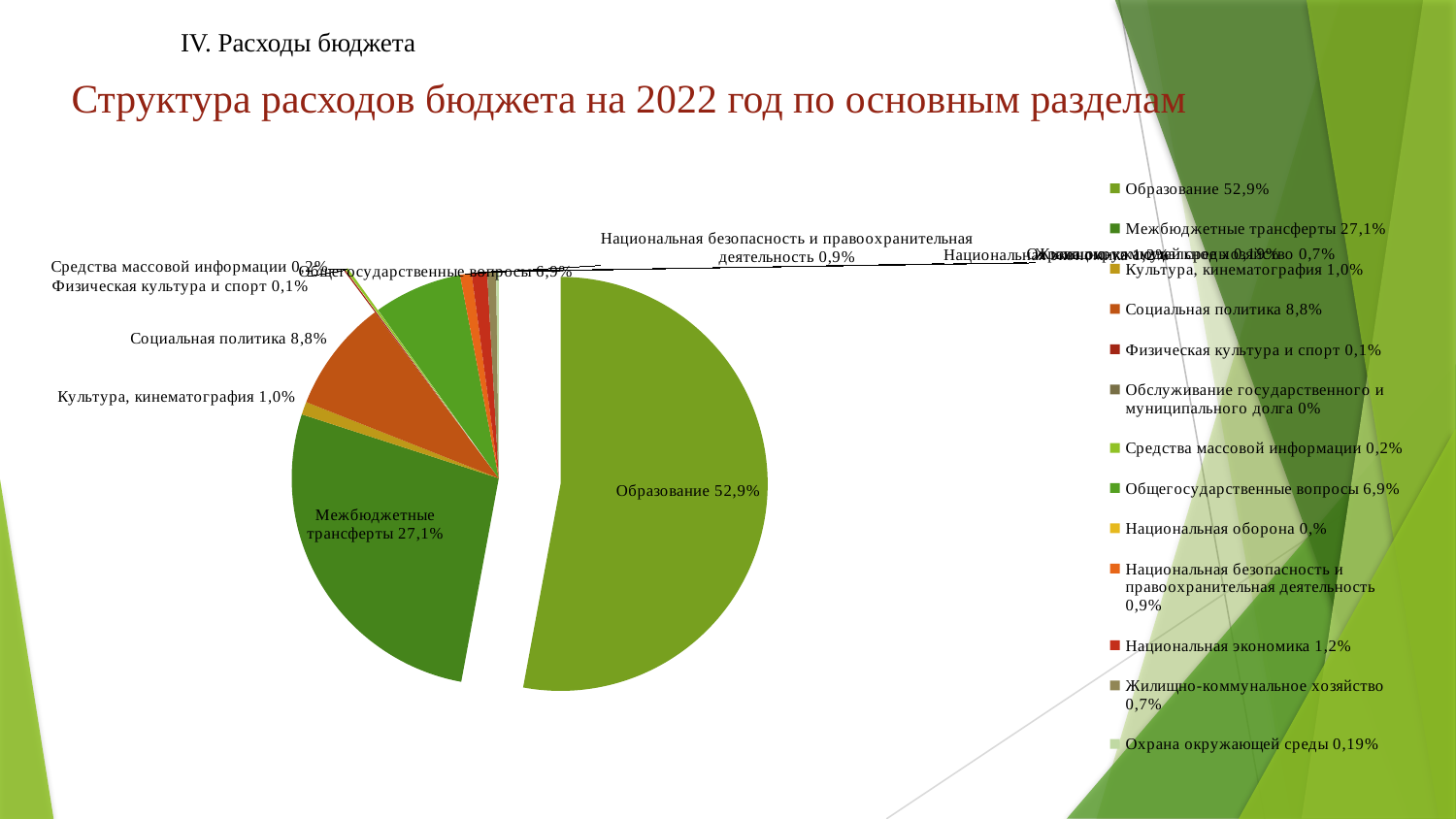
What is the value for Общегосударственные вопросы? 6,9% What kind of chart is shown on the slide? Pie chart What is the difference between the shares of Образование and Межбюджетные трансферты? 25,8% How many sections are listed in the chart legend? 13 What is the value for Межбюджетные трансферты? 27,1% What is the value for Социальная политика? 8,8% What is the value for Охрана окружающей среды? 0,19% What is the value for Национальная экономика? 1,2% What is the title of the chart on the slide? Структура расходов бюджета на 2022 год по основным разделам Which section has the largest share of the budget expenditure? Образование What share of the budget expenditure goes to Образование? 52,9% Which is larger, the share for Социальная политика or the share for Общегосударственные вопросы? Социальная политика